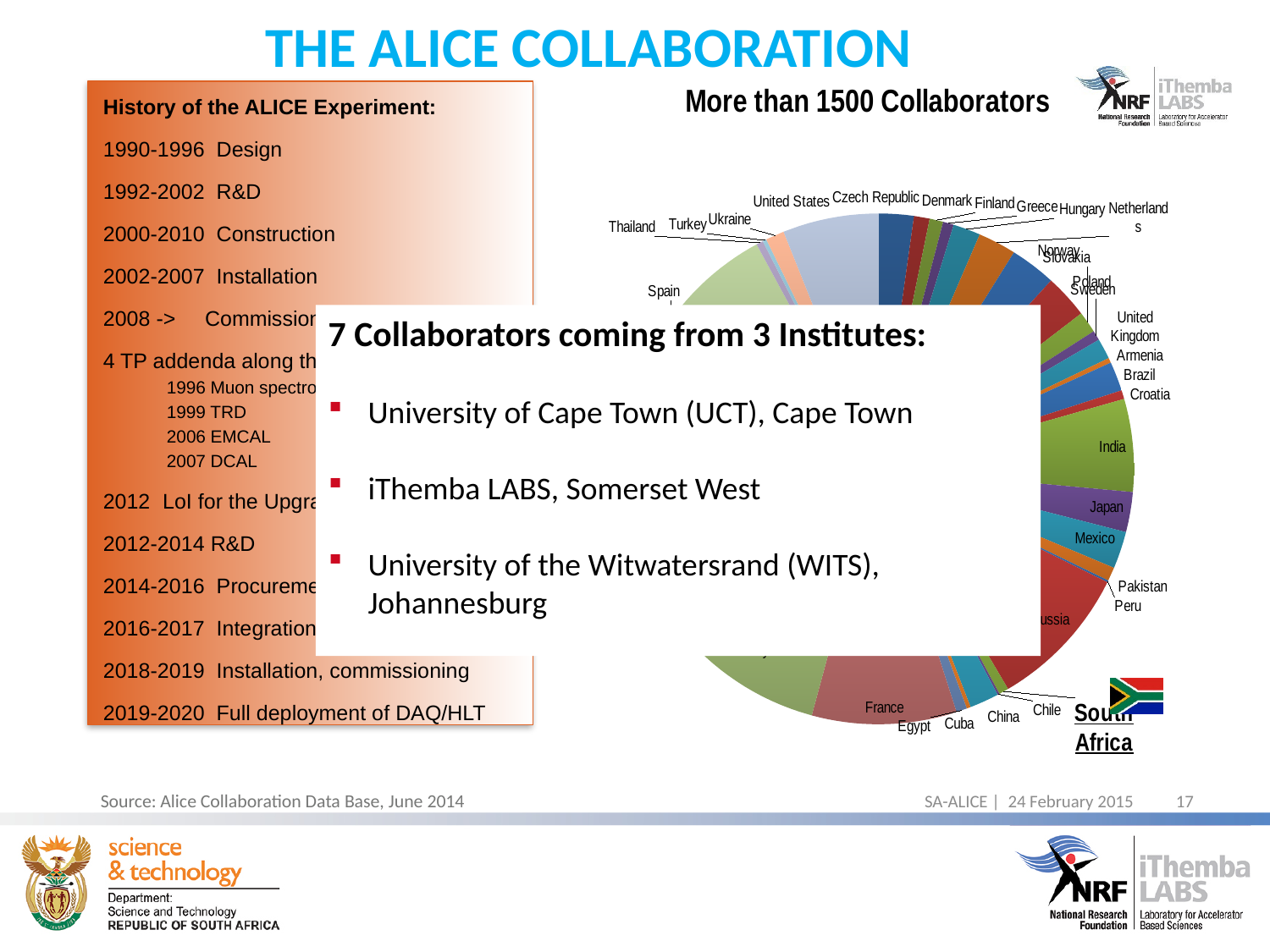
What kind of chart is shown on the slide? pie chart Which slice of the pie chart is larger, France or Cuba? France Which slice of the pie chart is larger, India or Japan? India Which country's label on the pie chart is shown next to a national flag? South Africa What is the title shown above the pie chart? More than 1500 Collaborators Which slice of the pie chart is larger, United States or Thailand? United States